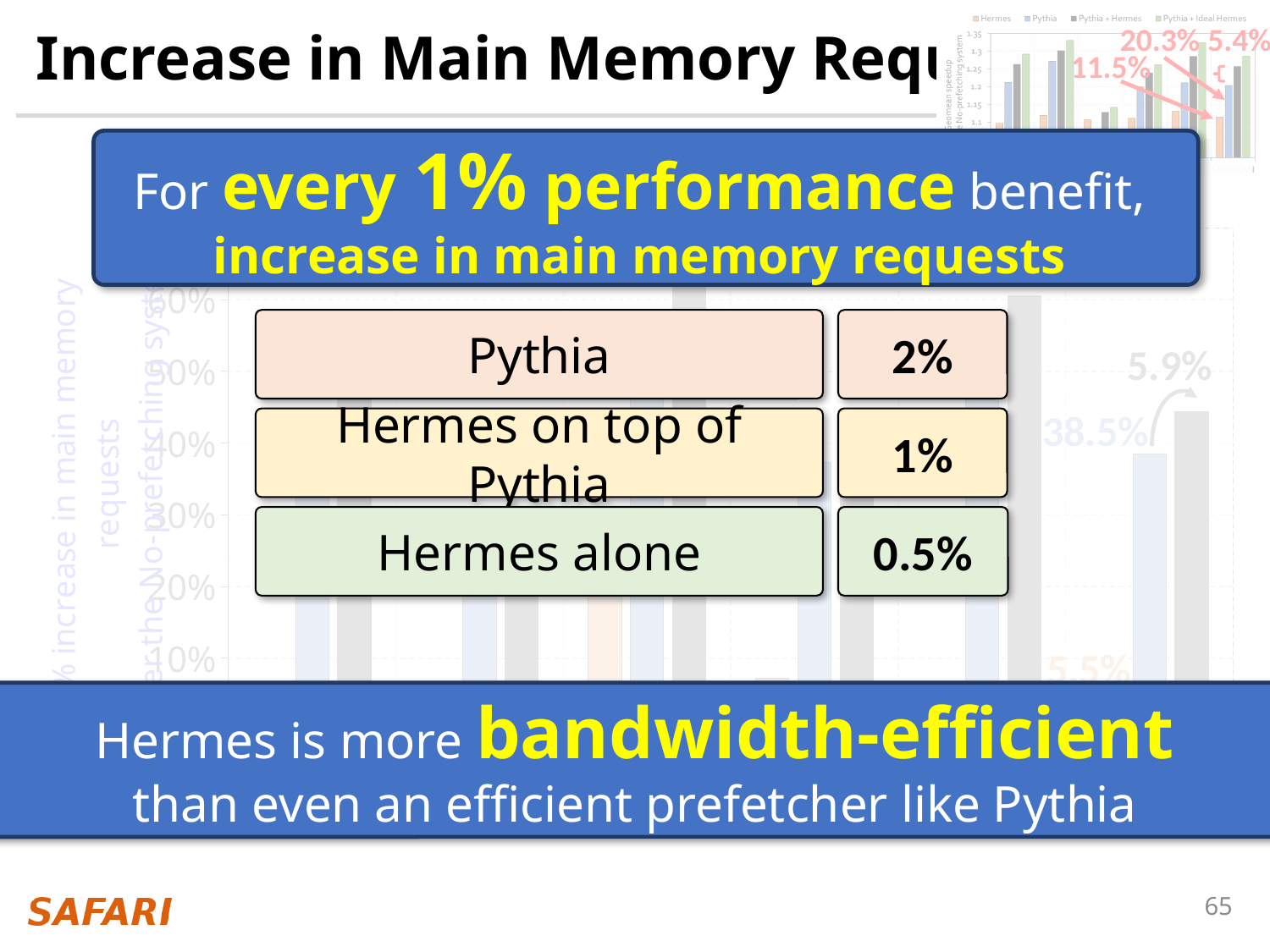
According to the overlay on the slide, what is the increase in main memory requests for every 1% performance benefit for Hermes alone? 0.5% What kind of chart is the small inset chart in the top-right corner of the slide? Bar chart According to the overlay on the slide, what is the increase in main memory requests for every 1% performance benefit for Hermes on top of Pythia? 1% What kind of chart is the large faded chart in the background of the slide? Bar chart Among Pythia, Hermes on top of Pythia, and Hermes alone, which has the smallest increase in main memory requests per 1% performance benefit? Hermes alone Among Pythia, Hermes on top of Pythia, and Hermes alone, which has the largest increase in main memory requests per 1% performance benefit? Pythia According to the overlay on the slide, what is the increase in main memory requests for every 1% performance benefit for Pythia? 2% What is the largest percentage annotation shown on the small inset chart in the top-right corner? 20.3% What is the difference between the per-1%-performance increase in main memory requests for Pythia and for Hermes alone? 1.5% How many series does the legend of the small inset chart in the top-right corner list? 4 Which has a larger increase in main memory requests per 1% performance benefit: Hermes on top of Pythia or Hermes alone? Hermes on top of Pythia